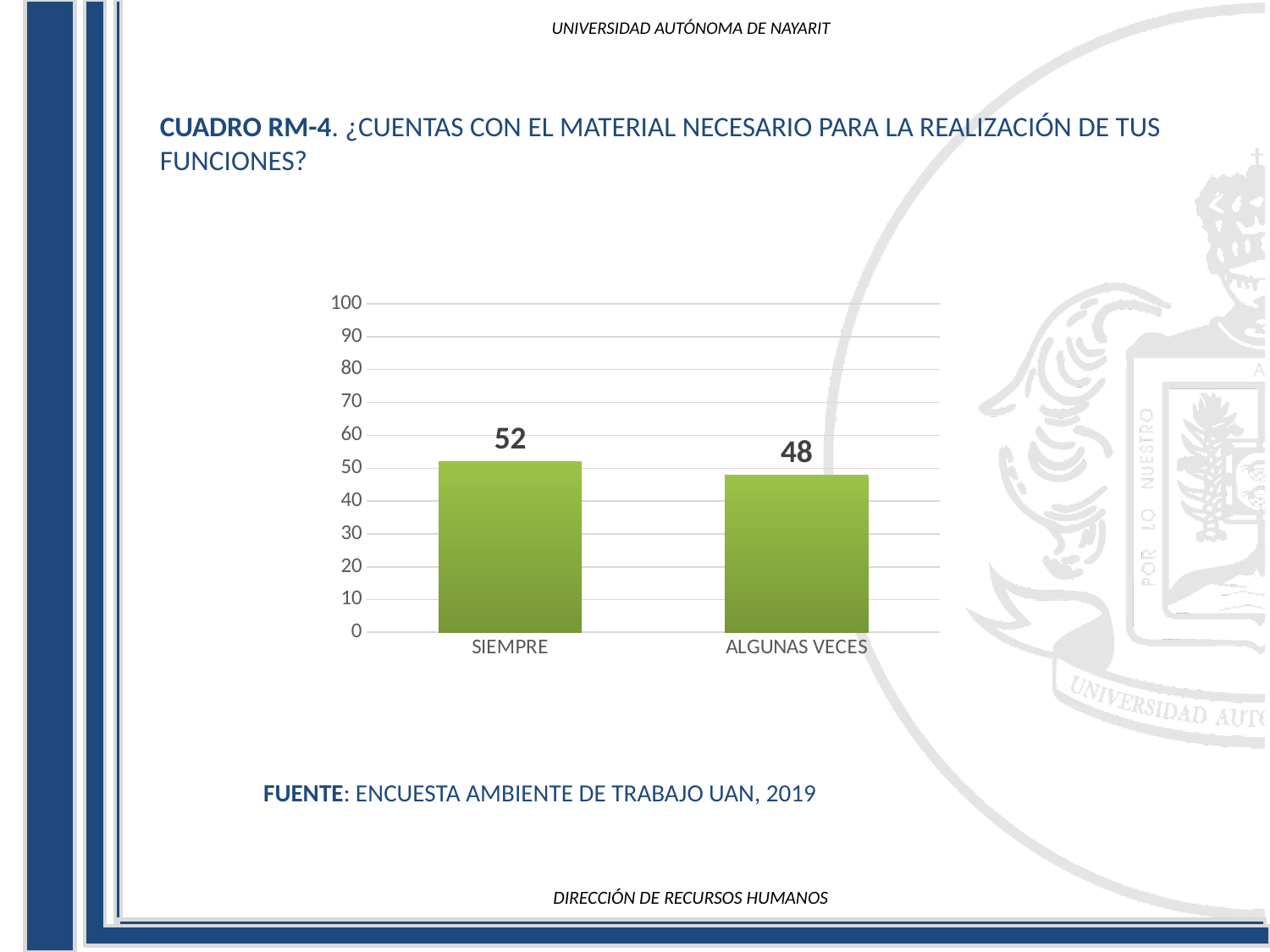
What kind of chart is shown on the slide? bar chart Is the value for SIEMPRE greater or less than 50? greater Which category has the lowest value? ALGUNAS VECES Which is larger, the value for SIEMPRE or the value for ALGUNAS VECES? SIEMPRE Is the value for ALGUNAS VECES greater or less than 50? less What is the difference between the values for SIEMPRE and ALGUNAS VECES? 4 Which category has the highest value? SIEMPRE What is the maximum value shown on the vertical axis? 100 How many categories are shown on the chart? 2 What is the value for SIEMPRE? 52 What is the value for ALGUNAS VECES? 48 What is the total of the two values shown on the chart? 100